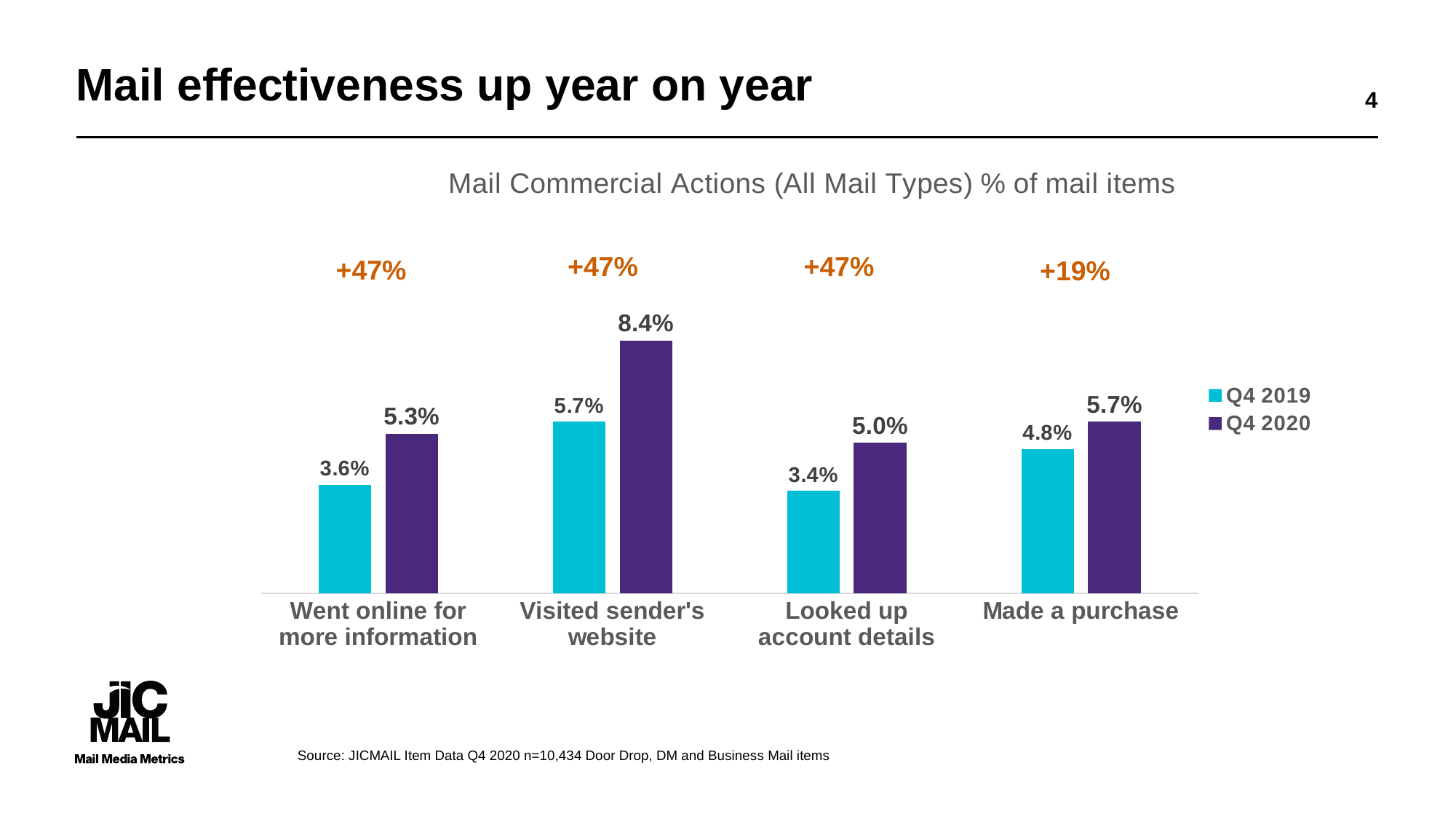
Which category has the highest Q4 2020 value? Visited sender's website How many categories are shown on the x axis? 4 What is the Q4 2019 value for "Made a purchase"? 4.8% What is the difference between the Q4 2020 and Q4 2019 values for "Went online for more information"? 1.7% How many series does the legend list? 2 Which is larger: the Q4 2020 value for "Made a purchase" or the Q4 2020 value for "Looked up account details"? Made a purchase What percentage change is shown above "Made a purchase"? +19% What is the Q4 2019 value for "Looked up account details"? 3.4% What kind of chart is shown on the slide? Bar chart Which category has the lowest Q4 2019 value? Looked up account details What is the Q4 2020 value for "Visited sender's website"? 8.4% What is the chart's title? Mail Commercial Actions (All Mail Types) % of mail items